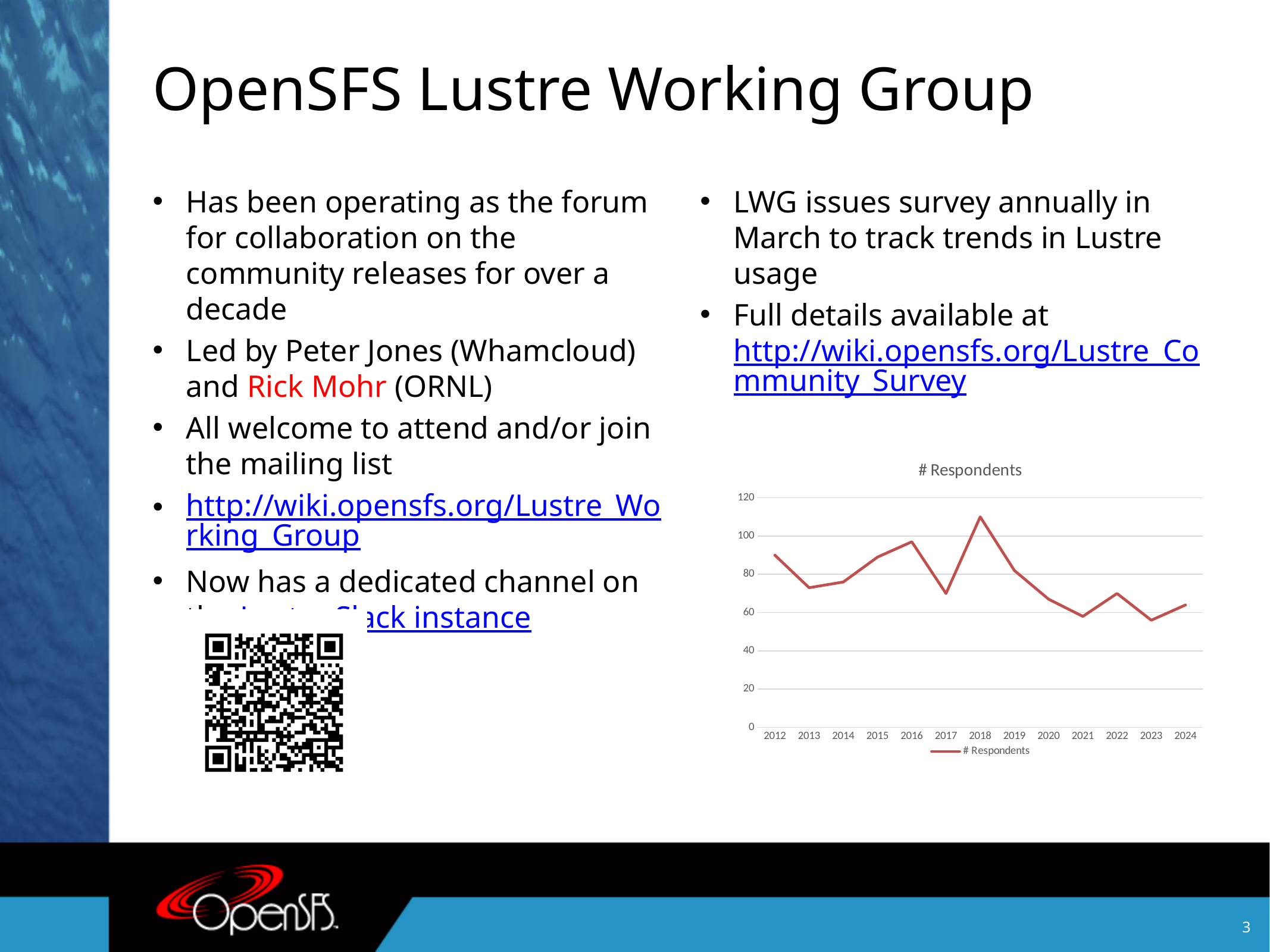
Which year has the highest number of respondents? 2018 Is the number of respondents for 2016 greater or less than 80? greater What kind of chart is shown on the slide? line chart Is the number of respondents for 2013 greater or less than 80? less How many years are plotted along the x axis of the chart? 13 How many series does the chart legend list? 1 Which year has more respondents, 2016 or 2017? 2016 Is the number of respondents for 2018 greater or less than 100? greater Do the number of respondents rise or fall from 2018 to 2021? fall Which year has more respondents, 2012 or 2013? 2012 Do the number of respondents rise or fall from 2013 to 2016? rise What is the title of the chart on the slide? # Respondents